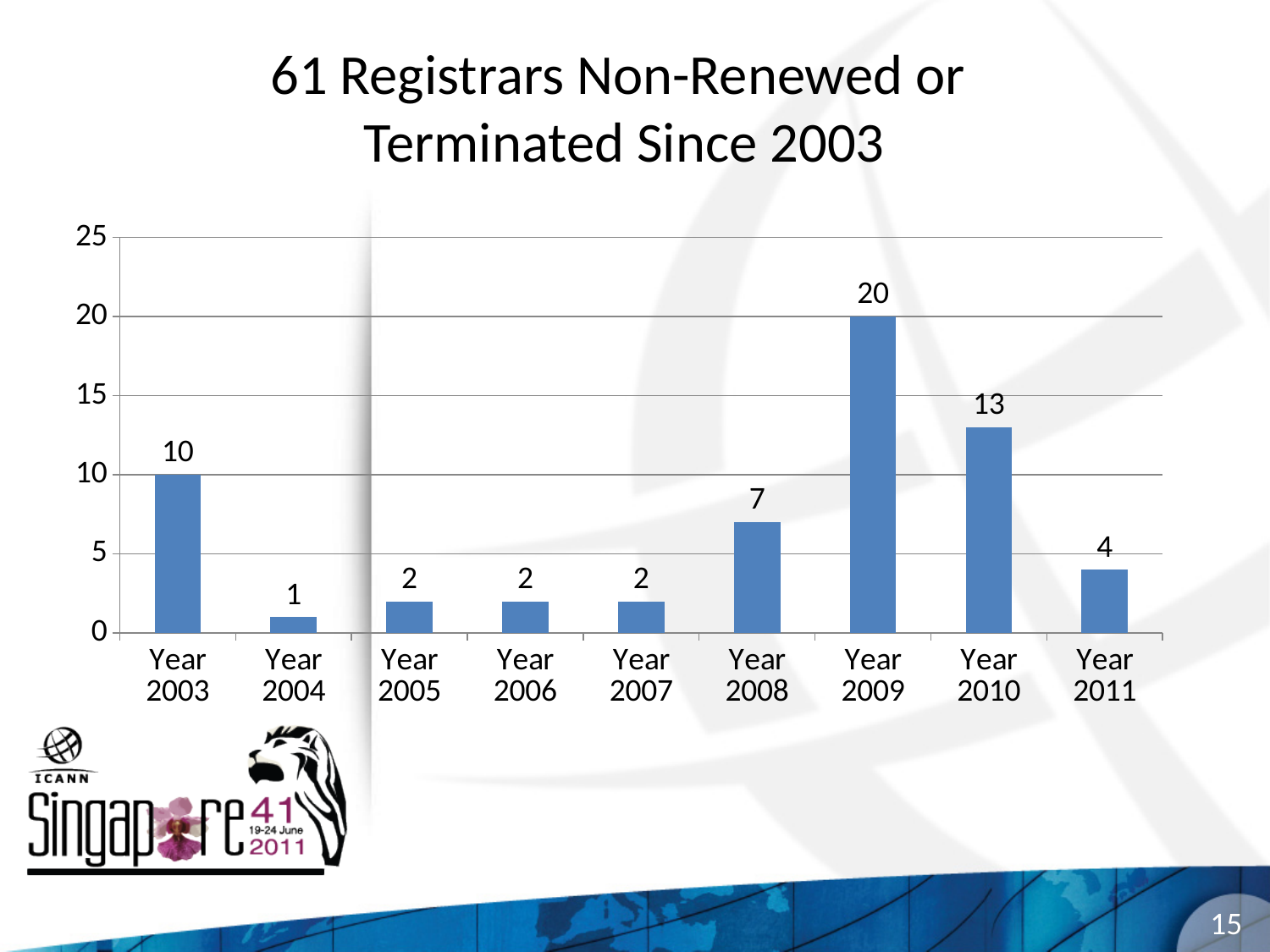
What is the value for Year 2009? 20 Do the values rise or fall from Year 2007 to Year 2009? rise What kind of chart is shown on the slide? bar chart Which year has the lowest value? Year 2004 Is the value for Year 2010 greater or less than 10? greater Which year has the highest value? Year 2009 What is the value for Year 2003? 10 What is the value for Year 2011? 4 What is the difference between the values for Year 2009 and Year 2010? 7 Which is larger, the value for Year 2008 or the value for Year 2003? Year 2003 What is the title of the chart? 61 Registrars Non-Renewed or Terminated Since 2003 How many years are shown on the x axis? 9